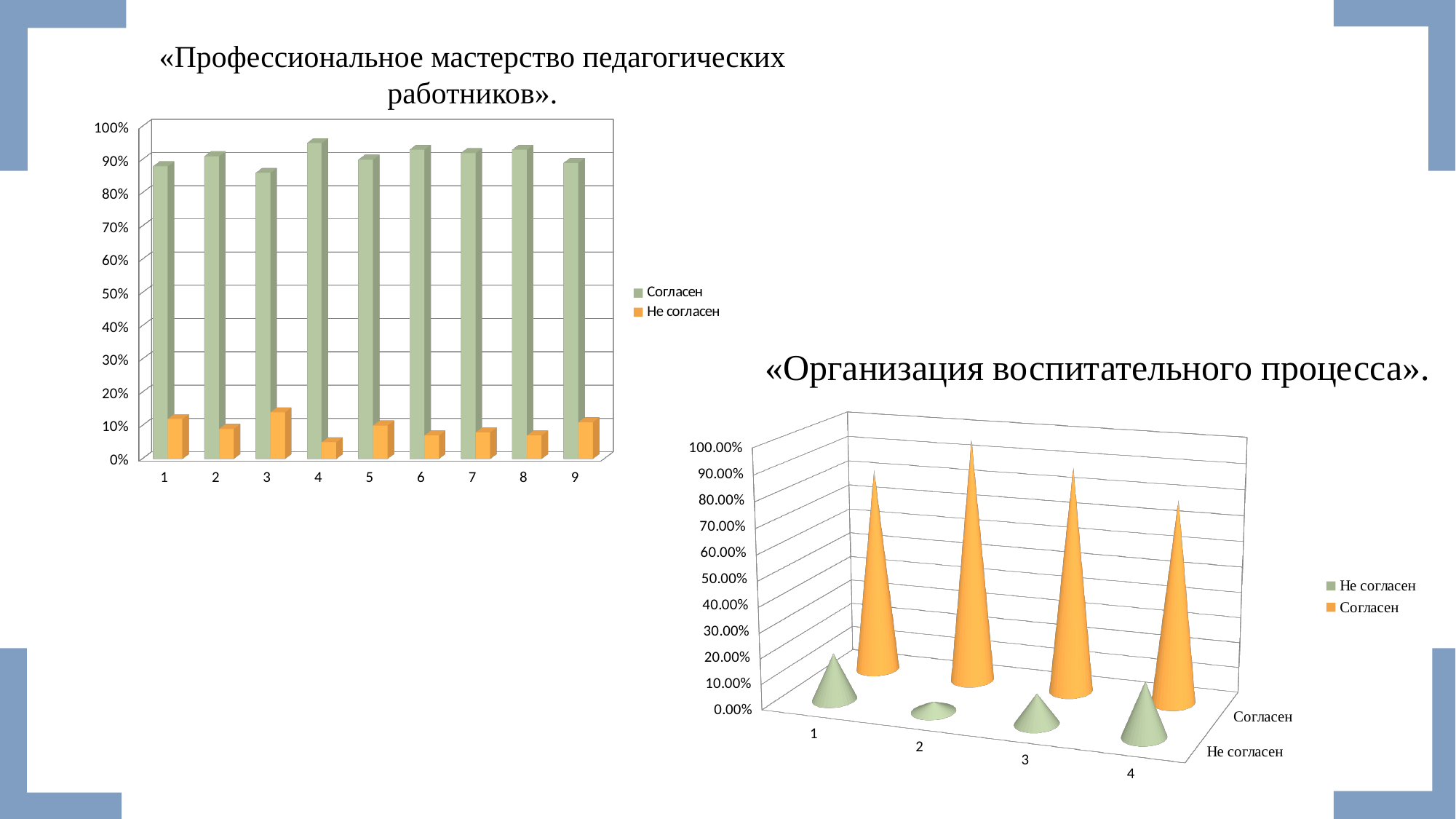
In the chart titled «Профессиональное мастерство педагогических работников», how many categories are shown on the x axis? 9 What kind of chart is the one titled «Профессиональное мастерство педагогических работников»? Bar chart In the chart titled «Профессиональное мастерство педагогических работников», which category has the lowest value for Не согласен? 4 In the chart titled «Профессиональное мастерство педагогических работников», how many series does the legend list? 2 In the chart titled «Организация воспитательного процесса», which category has the highest value for Согласен? 2 In the chart titled «Профессиональное мастерство педагогических работников», which category has the highest value for Не согласен? 3 In the chart titled «Профессиональное мастерство педагогических работников», which category has the highest value for Согласен? 4 In the chart titled «Профессиональное мастерство педагогических работников», is the value for Не согласен in category 3 greater or less than 10%? greater In the chart titled «Организация воспитательного процесса», which colour represents the Согласен series? Orange In the chart titled «Организация воспитательного процесса», is the value for Не согласен in category 2 greater or less than 10.00%? less In the chart titled «Организация воспитательного процесса», how many categories are shown on the x axis? 4 In the chart titled «Профессиональное мастерство педагогических работников», is the value for Согласен in category 4 greater or less than 90%? greater